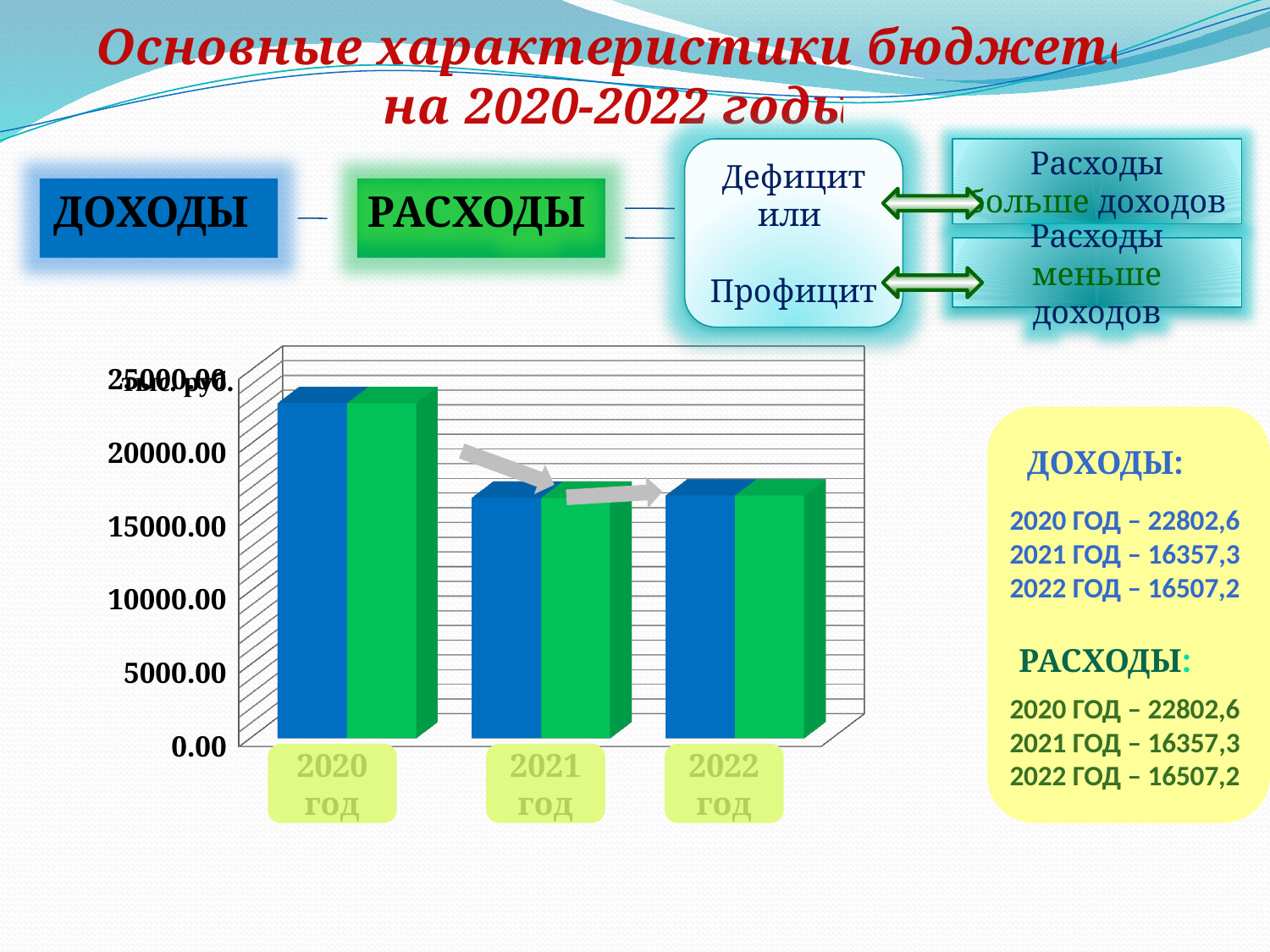
What is the value of ДОХОДЫ for 2020 год? 22802,6 Which year has the highest bars in the chart? 2020 год Which year has the lowest value for ДОХОДЫ? 2021 год Which is larger: ДОХОДЫ in 2020 год or ДОХОДЫ in 2022 год? 2020 год What colour are the ДОХОДЫ bars in the chart? blue Is the value for РАСХОДЫ in 2020 год greater or less than 20000.00? greater Is the value for ДОХОДЫ in 2021 год greater or less than 20000.00? less Do the values rise or fall from 2020 год to 2021 год? fall How many years (categories) are shown on the x axis of the chart? 3 What is the value of РАСХОДЫ for 2022 год? 16507,2 What is the difference between ДОХОДЫ in 2020 год and ДОХОДЫ in 2021 год? 6445,3 What kind of chart is shown on the slide? bar chart